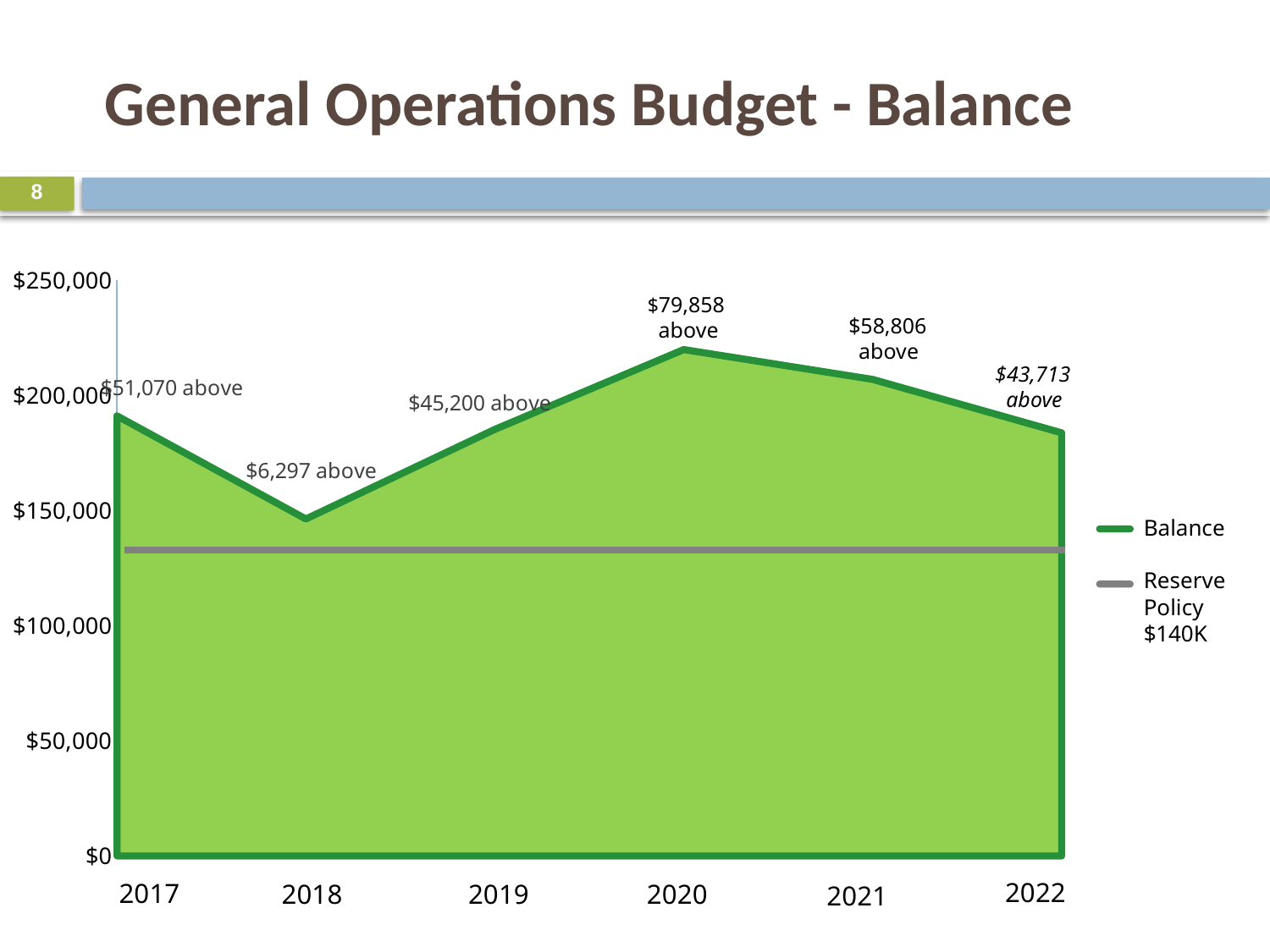
What kind of chart is shown on the slide? Area chart In which year is the Balance highest? 2020 Is the Balance for 2020 greater or less than $200,000? greater In which year is the Balance lowest? 2018 Is the Balance for 2018 greater or less than $150,000? less What does the data label for 2022 say? $43,713 above Which year has a larger Balance, 2017 or 2018? 2017 What does the data label for 2018 say? $6,297 above How many series does the chart's legend list? 2 How many years are shown on the x axis of the chart? 6 Does the Balance rise or fall from 2020 to 2022? Fall What does the data label for 2020 say? $79,858 above